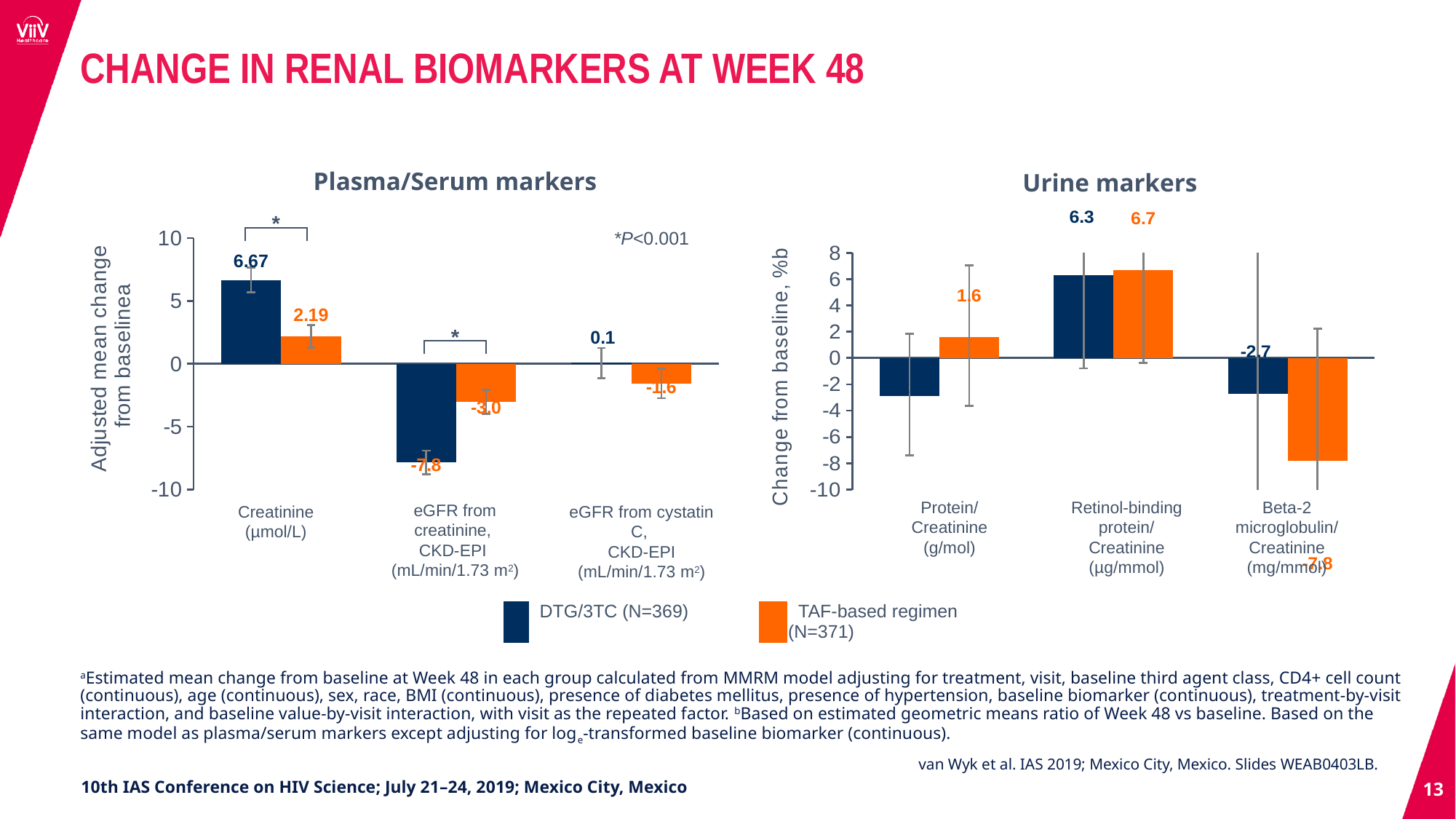
In the Urine markers chart, what is the value for DTG/3TC for Beta-2 microglobulin/Creatinine? -2.7 How many categories are shown on the x axis of the Urine markers chart? 3 In the Plasma/Serum markers chart, what is the value for DTG/3TC for eGFR from cystatin C, CKD-EPI? 0.1 In the Plasma/Serum markers chart, what is the difference between the DTG/3TC and TAF-based regimen values for Creatinine (µmol/L)? 4.48 In the Plasma/Serum markers chart, which category has the lowest DTG/3TC value? eGFR from creatinine, CKD-EPI How many series does the legend list for the charts? 2 In the Plasma/Serum markers chart, what is the value for the TAF-based regimen for eGFR from creatinine, CKD-EPI? -3.0 In the Urine markers chart, is the DTG/3TC value for Protein/Creatinine greater or less than 0? less In the Plasma/Serum markers chart, what is the value for DTG/3TC for Creatinine (µmol/L)? 6.67 In the Urine markers chart, which is larger for Beta-2 microglobulin/Creatinine: the DTG/3TC value or the TAF-based regimen value? DTG/3TC What kind of chart is the Plasma/Serum markers chart? Bar chart In the Urine markers chart, what is the value for the TAF-based regimen for Retinol-binding protein/Creatinine? 6.7